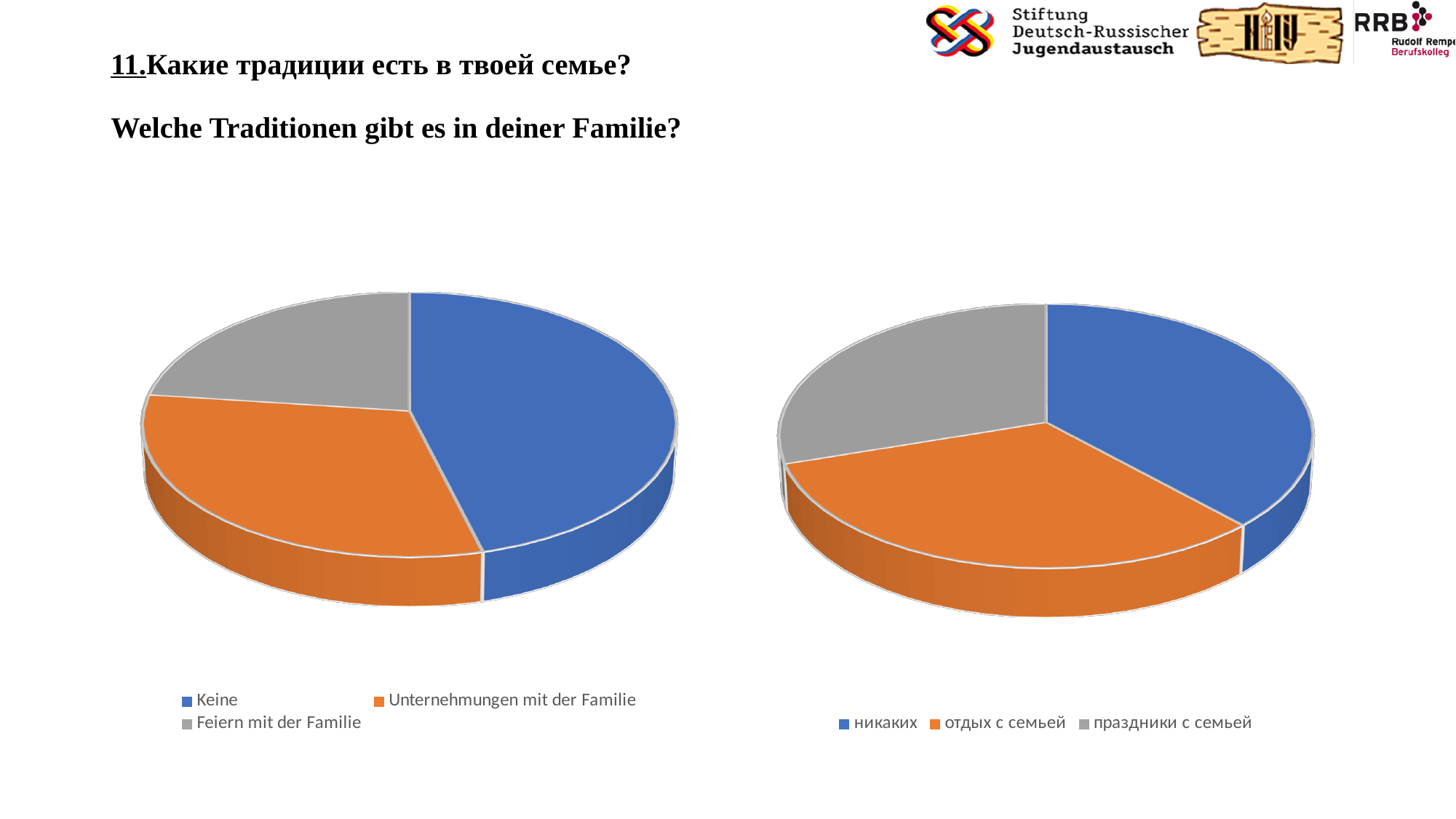
In the left pie chart, which slice is larger: Keine or Feiern mit der Familie? Keine How many slices does the right pie chart have? 3 How many entries does the legend of the left chart list? 3 How many slices does the left pie chart have? 3 What kind of chart is the right chart on the slide? pie chart What kind of chart is the left chart on the slide? pie chart In the left pie chart, what colour is the slice for Unternehmungen mit der Familie? orange In the left pie chart, which category has the smallest slice? Feiern mit der Familie How many entries does the legend of the right chart list? 3 In the right pie chart, which slice is larger: отдых с семьей or праздники с семьей? отдых с семьей In the left pie chart, which category has the largest slice? Keine In the right pie chart, which category has the smallest slice? праздники с семьей